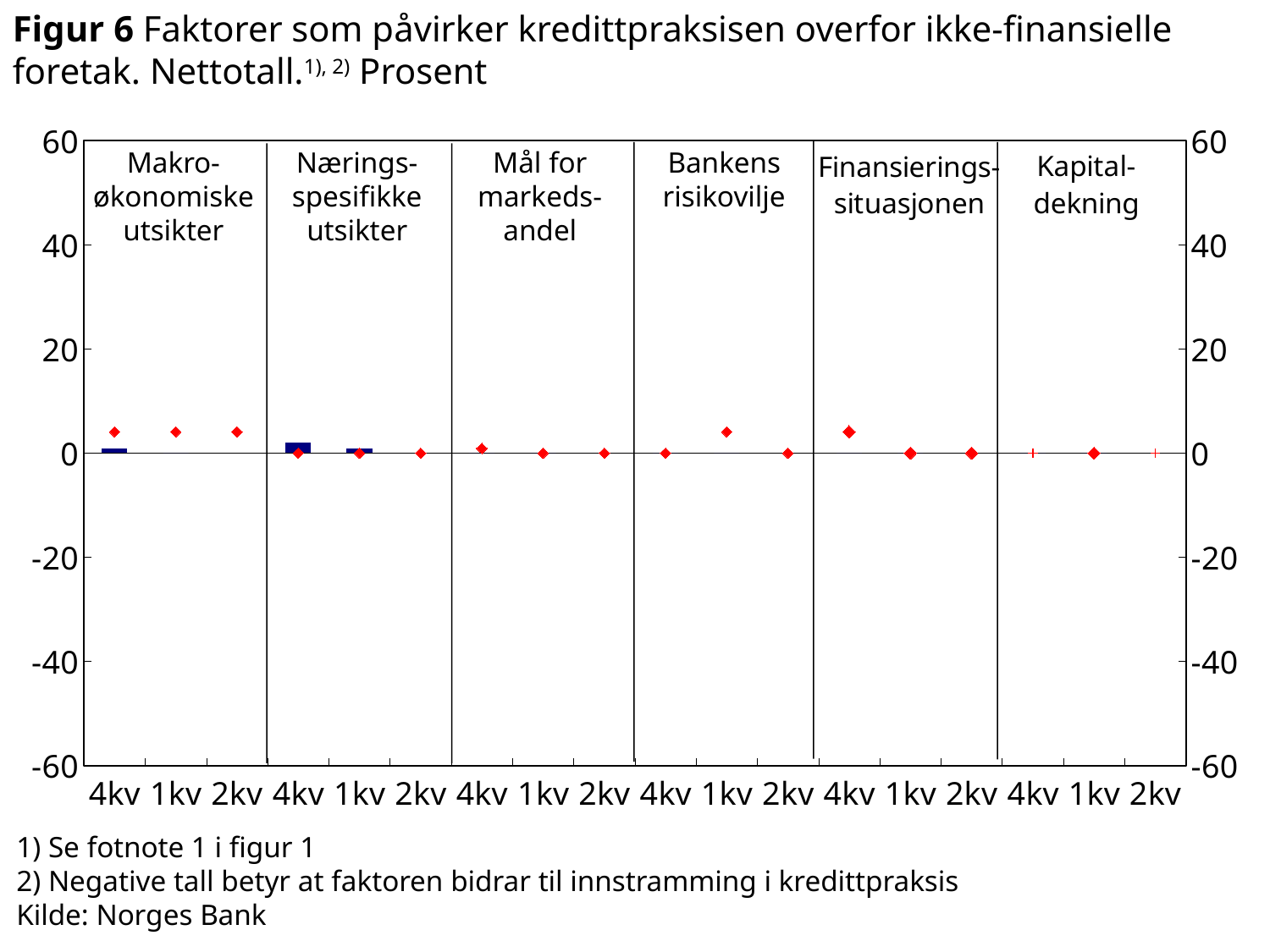
Is the value for Makroøkonomiske utsikter in 4kv greater or less than 20? less What kind of chart is shown on the slide? combination bar and line chart What is the title of the chart? Figur 6 Faktorer som påvirker kredittpraksisen overfor ikke-finansielle foretak. Nettotall. Prosent How many factor panels are shown in the chart? 6 How many quarters are shown within each factor panel? 3 Is the value for Bankens risikovilje in 1kv greater or less than -20? greater Is the value for Kapitaldekning in 2kv greater or less than 20? less Which quarter labels appear on the x axis of each panel? 4kv, 1kv, 2kv What is the lowest value shown on the y axis? -60